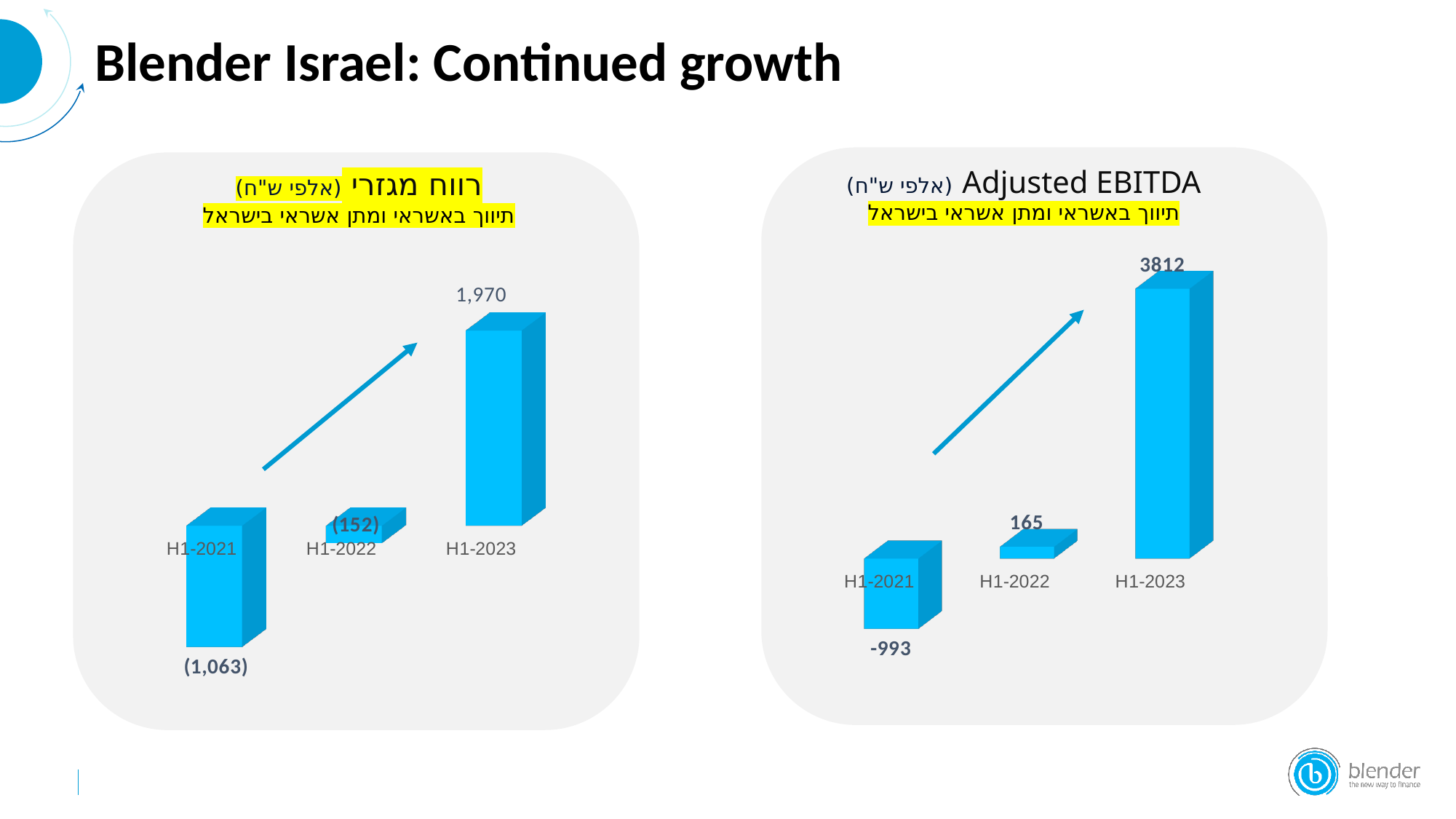
In the Adjusted EBITDA chart on the right, what is the difference between the H1-2023 and H1-2022 values? 3647 In the left chart (רווח מגזרי), which period has the lowest value? H1-2021 In the left chart (רווח מגזרי), which is larger: the value for H1-2022 or the value for H1-2023? H1-2023 In the Adjusted EBITDA chart on the right, what is the value for H1-2021? -993 In the left chart (רווח מגזרי), what is the value for H1-2022? (152) In the Adjusted EBITDA chart on the right, what is the value for H1-2023? 3812 What type of chart is the left chart (רווח מגזרי)? Bar chart In the Adjusted EBITDA chart on the right, what is the value for H1-2022? 165 In the Adjusted EBITDA chart on the right, which period has the highest value? H1-2023 In the left chart (רווח מגזרי), what is the value for H1-2023? 1,970 How many periods are shown in the Adjusted EBITDA chart on the right? 3 In the left chart (רווח מגזרי), what is the value for H1-2021? (1,063)